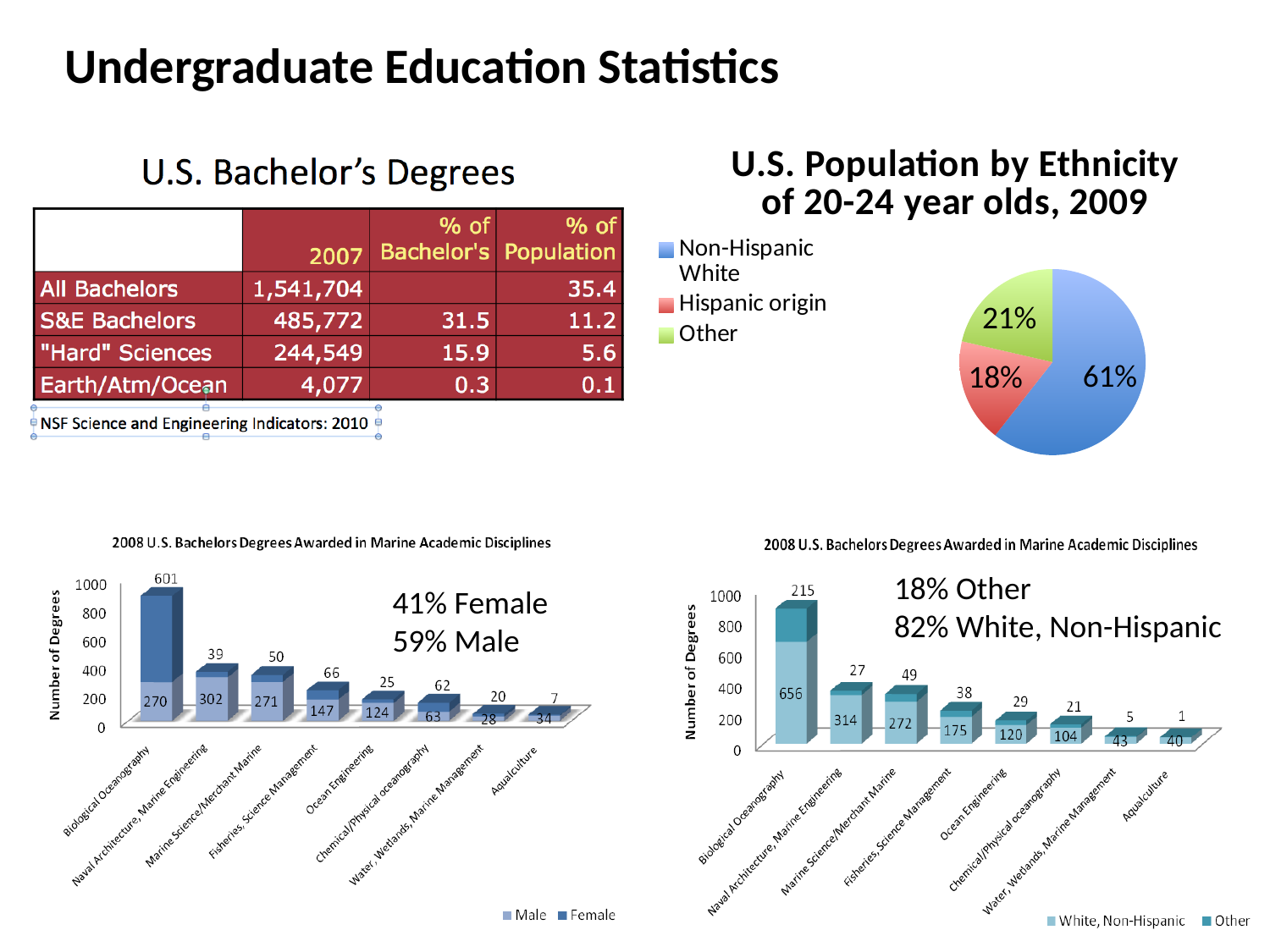
In the bottom-right bar chart (White, Non-Hispanic/Other), what is the difference between the White, Non-Hispanic values for Biological Oceanography and Naval Architecture, Marine Engineering? 342 In the bottom-left bar chart (Male/Female), how many Male degrees were awarded in Naval Architecture, Marine Engineering? 302 In the 'U.S. Population by Ethnicity of 20-24 year olds, 2009' pie chart, what share is Non-Hispanic White? 61% In the bottom-right bar chart (White, Non-Hispanic/Other), how many White, Non-Hispanic degrees were awarded in Fisheries, Science Management? 175 In the bottom-right bar chart (White, Non-Hispanic/Other), how many Other degrees were awarded in Aquaculture? 1 What kind of chart is the 'U.S. Population by Ethnicity of 20-24 year olds, 2009' chart? pie chart How many slices does the 'U.S. Population by Ethnicity of 20-24 year olds, 2009' pie chart have? 3 In the bottom-left bar chart (Male/Female), how many categories are shown on the x axis? 8 How many series does the legend of the bottom-left bar chart list? 2 In the bottom-left bar chart (Male/Female), how many Female degrees were awarded in Biological Oceanography? 601 In the bottom-left bar chart (Male/Female), what is the total number of degrees for Biological Oceanography (Male plus Female)? 871 In the 'U.S. Population by Ethnicity of 20-24 year olds, 2009' pie chart, which category has the smallest share? Hispanic origin